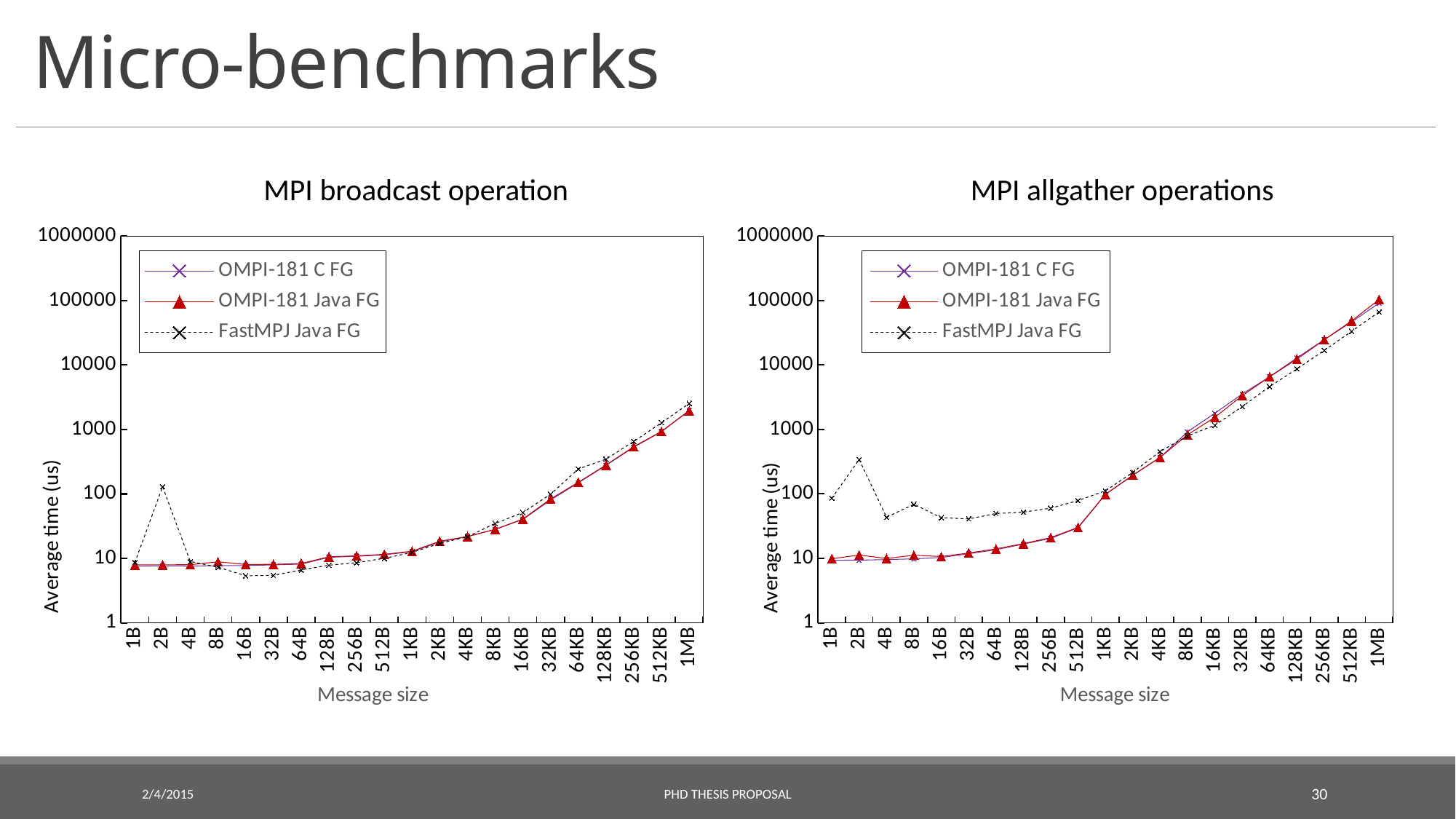
What kind of chart is the MPI broadcast operation chart? line chart How many message sizes are shown on the x axis of the MPI broadcast operation chart? 21 In the MPI allgather operations chart, which is larger at 1MB: OMPI-181 Java FG or FastMPJ Java FG? OMPI-181 Java FG In the MPI broadcast operation chart, which is larger at 2B: FastMPJ Java FG or OMPI-181 Java FG? FastMPJ Java FG What is the y-axis label of the MPI broadcast operation chart? Average time (us) In the MPI allgather operations chart, is the value for OMPI-181 Java FG at 1MB greater or less than 10000? greater How many series does the legend of the MPI allgather operations chart list? 3 In the MPI broadcast operation chart, is the value for OMPI-181 Java FG at 1MB greater or less than 1000? greater In the MPI broadcast operation chart, is the value for FastMPJ Java FG at 2B greater or less than 100? greater What is the title of the chart on the right of the slide? MPI allgather operations In the MPI allgather operations chart, does the OMPI-181 Java FG series generally rise or fall as message size increases from 1KB to 1MB? rise